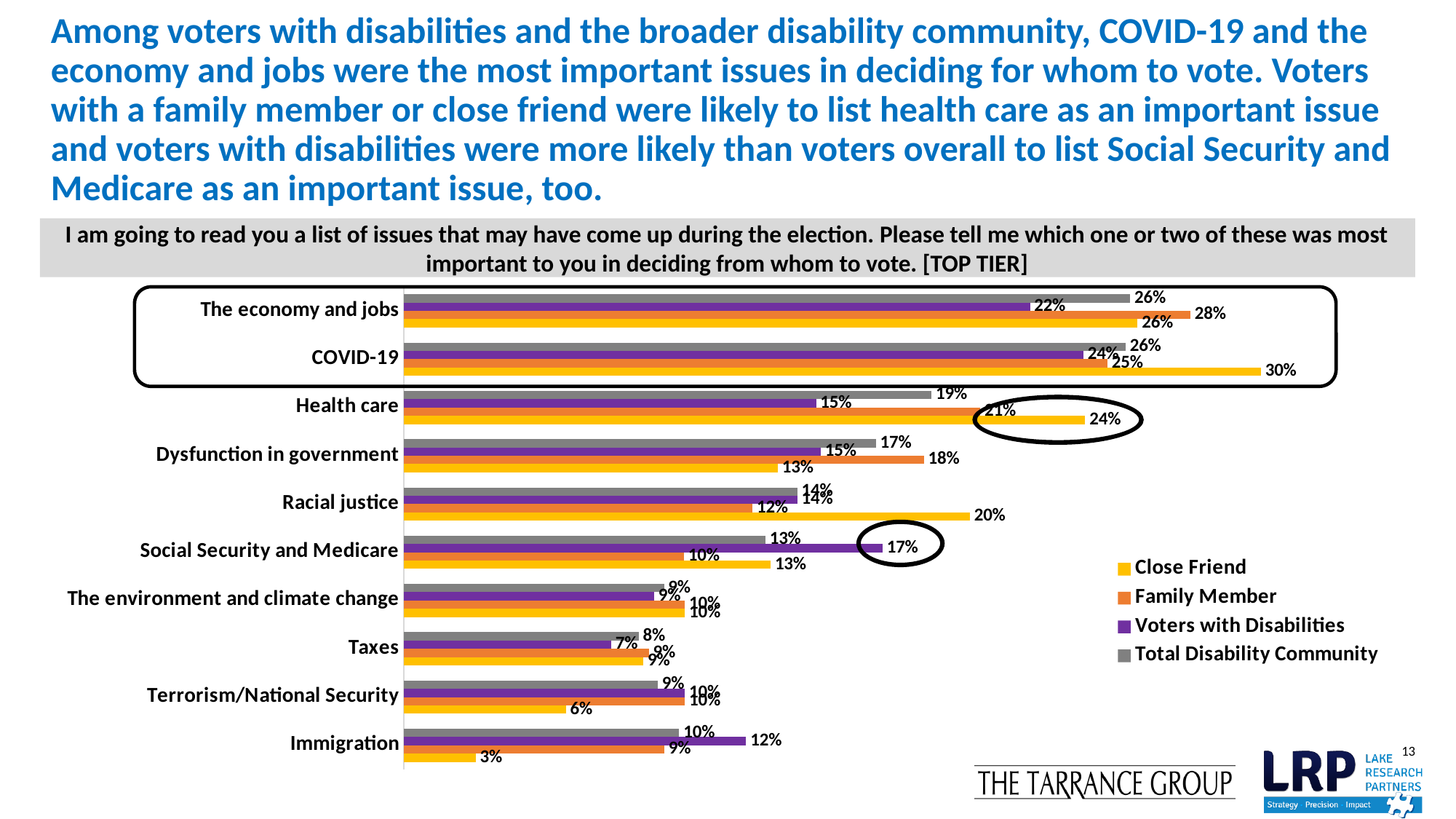
How many issue categories are plotted on the chart? 10 What is the Family Member value for The economy and jobs? 28% What is the difference between the Close Friend and Voters with Disabilities values for Health care? 9% Which issue has the highest Close Friend value? COVID-19 What is the Voters with Disabilities value for Social Security and Medicare? 17% Which issue has the lowest Close Friend value? Immigration What is the Close Friend value for COVID-19? 30% Which series is shown in purple in the legend? Voters with Disabilities For Racial justice, which is larger: the Close Friend value or the Family Member value? Close Friend What kind of chart is shown on the slide? bar chart What is the Close Friend value for Immigration? 3% How many series does the legend list? 4